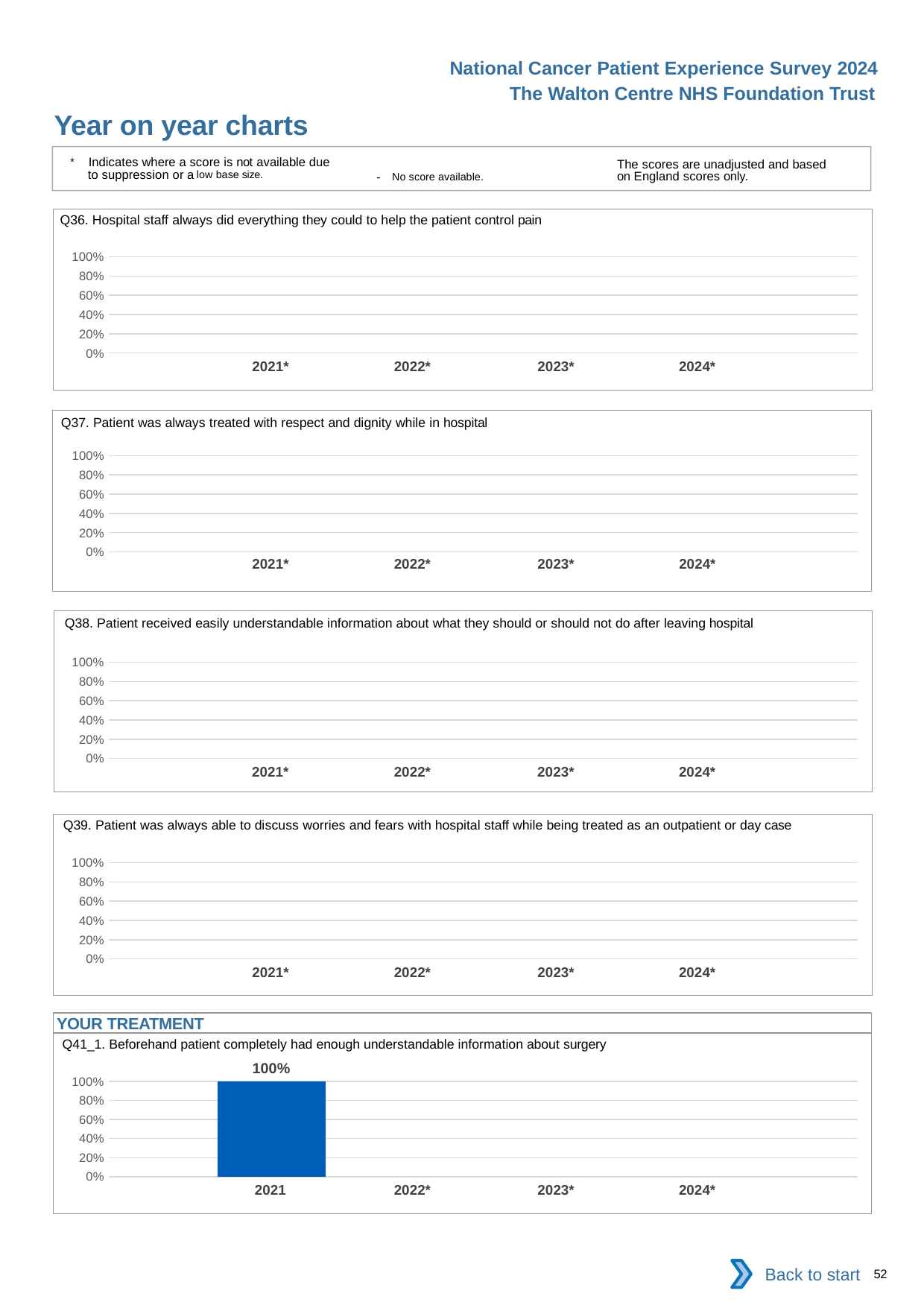
In the Q41_1 chart, what is the value for 2021? 100% In the Q41_1 chart, which year is the only one with a plotted bar? 2021 In the Q37 chart, what is the highest value shown on the y axis? 100% In the Q41_1 chart, is the value for 2021 greater or less than 80%? greater What kind of chart is the Q41_1 chart? bar chart In the Q41_1 chart, which year has the highest value? 2021 How many charts are on the slide? 5 In the Q39 chart, how many years have a plotted bar? 0 In the Q41_1 chart, how many years are shown on the x axis? 4